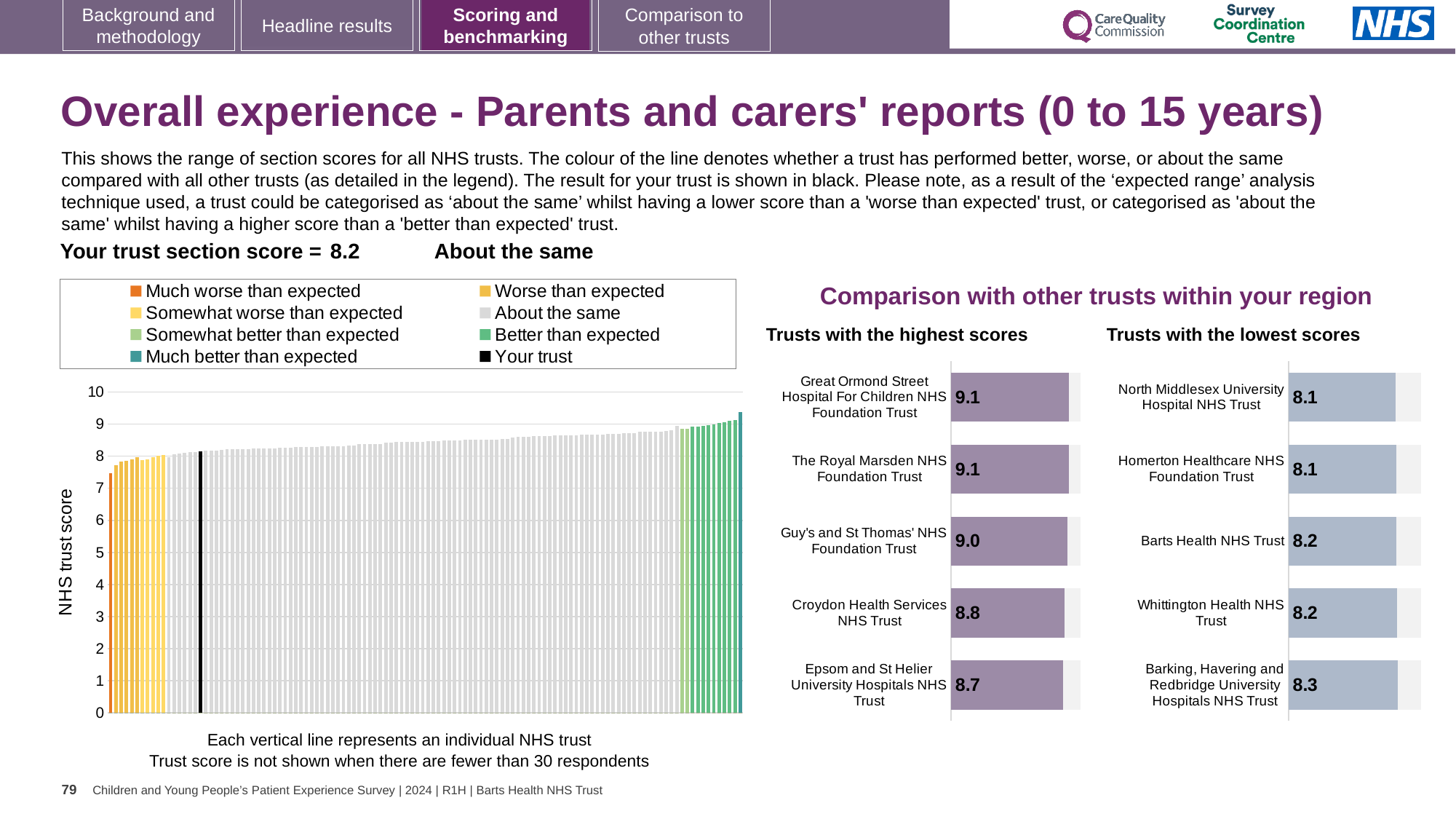
In the 'NHS trust score' chart, is the value of the leftmost (orange) bar greater or less than 8? less In the 'NHS trust score' chart, do the bar values rise or fall from left to right along the x axis? Rise What kind of chart is the large chart on the left with the y axis labelled 'NHS trust score'? Bar chart In the 'Trusts with the highest scores' chart, what is the score for Croydon Health Services NHS Trust? 8.8 In the 'NHS trust score' chart, is the value of the rightmost bar greater or less than 9? greater How many trusts are shown in the 'Trusts with the lowest scores' chart? 5 In the 'Trusts with the highest scores' chart, what is the difference between the scores of Great Ormond Street Hospital For Children NHS Foundation Trust and Epsom and St Helier University Hospitals NHS Trust? 0.4 How many entries does the legend above the 'NHS trust score' chart list? 8 In the 'Trusts with the lowest scores' chart, what is the score for Barts Health NHS Trust? 8.2 In the 'Trusts with the lowest scores' chart, which trust has the highest score? Barking, Havering and Redbridge University Hospitals NHS Trust In the 'Trusts with the highest scores' chart, which trust has the lowest score? Epsom and St Helier University Hospitals NHS Trust Which has the larger score: Guy's and St Thomas' NHS Foundation Trust in the 'Trusts with the highest scores' chart or Whittington Health NHS Trust in the 'Trusts with the lowest scores' chart? Guy's and St Thomas' NHS Foundation Trust